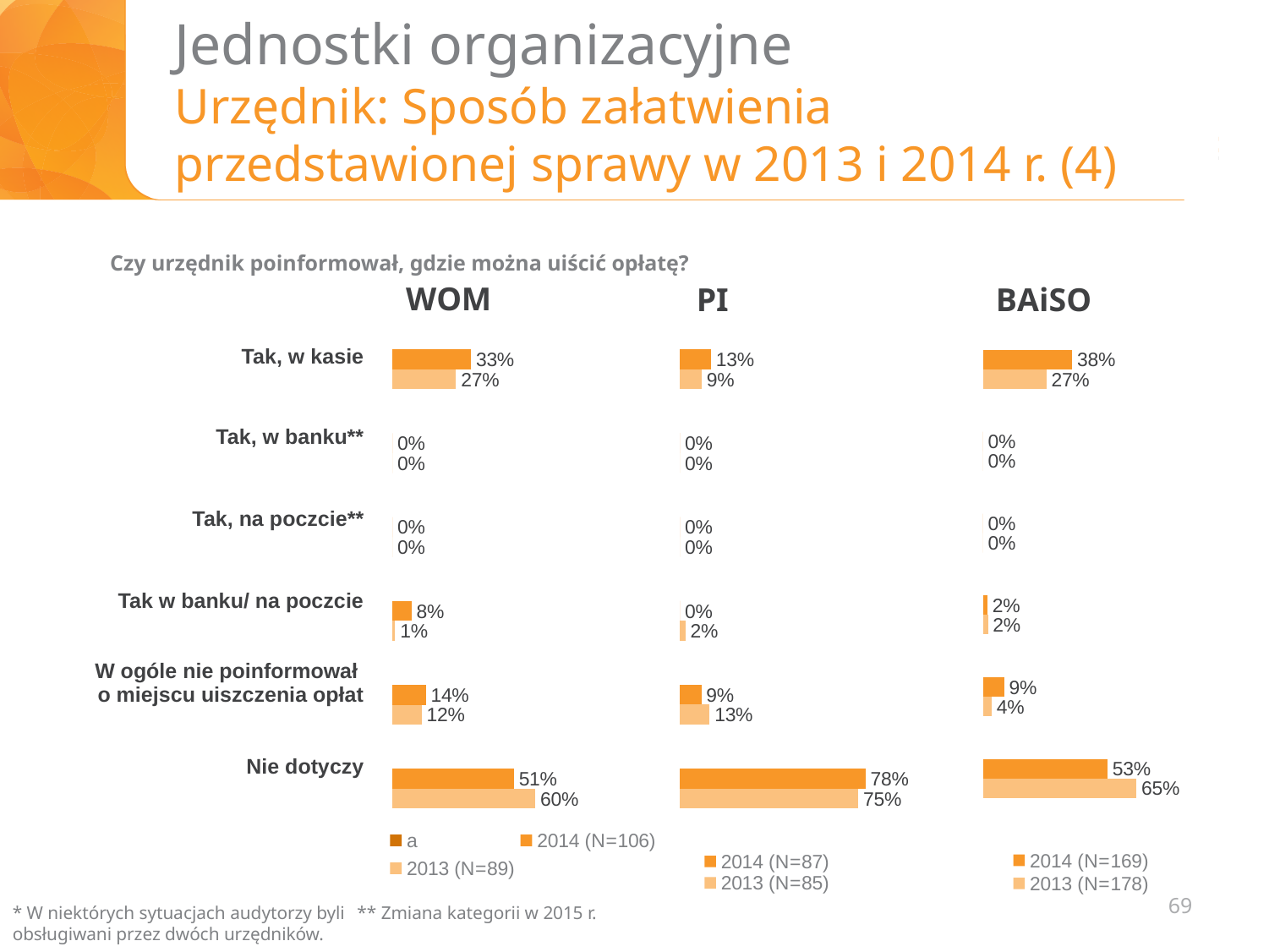
In the PI chart, which category has the highest 2014 value? Nie dotyczy In the WOM chart, what is the 2014 value for "Tak, w kasie"? 33% In the BAiSO chart, which category has the highest 2013 value? Nie dotyczy In the PI chart, which is larger for "Tak, w kasie": the 2014 value or the 2013 value? 2014 In the WOM chart, what is the difference between the 2013 and 2014 values for "Nie dotyczy"? 9% In the BAiSO chart, what is the difference between the 2014 and 2013 values for "Tak, w kasie"? 11% In the WOM chart, which is larger for "Tak w banku/ na poczcie": the 2014 value or the 2013 value? 2014 In the BAiSO chart, what is the 2014 value for "W ogóle nie poinformował o miejscu uiszczenia opłat"? 9% In the PI chart, what is the 2013 value for "Nie dotyczy"? 75% How many categories are shown in the PI chart? 6 What type of chart is used for the BAiSO data? Bar chart According to the legend of the PI chart, what is the sample size (N) for 2014? 87